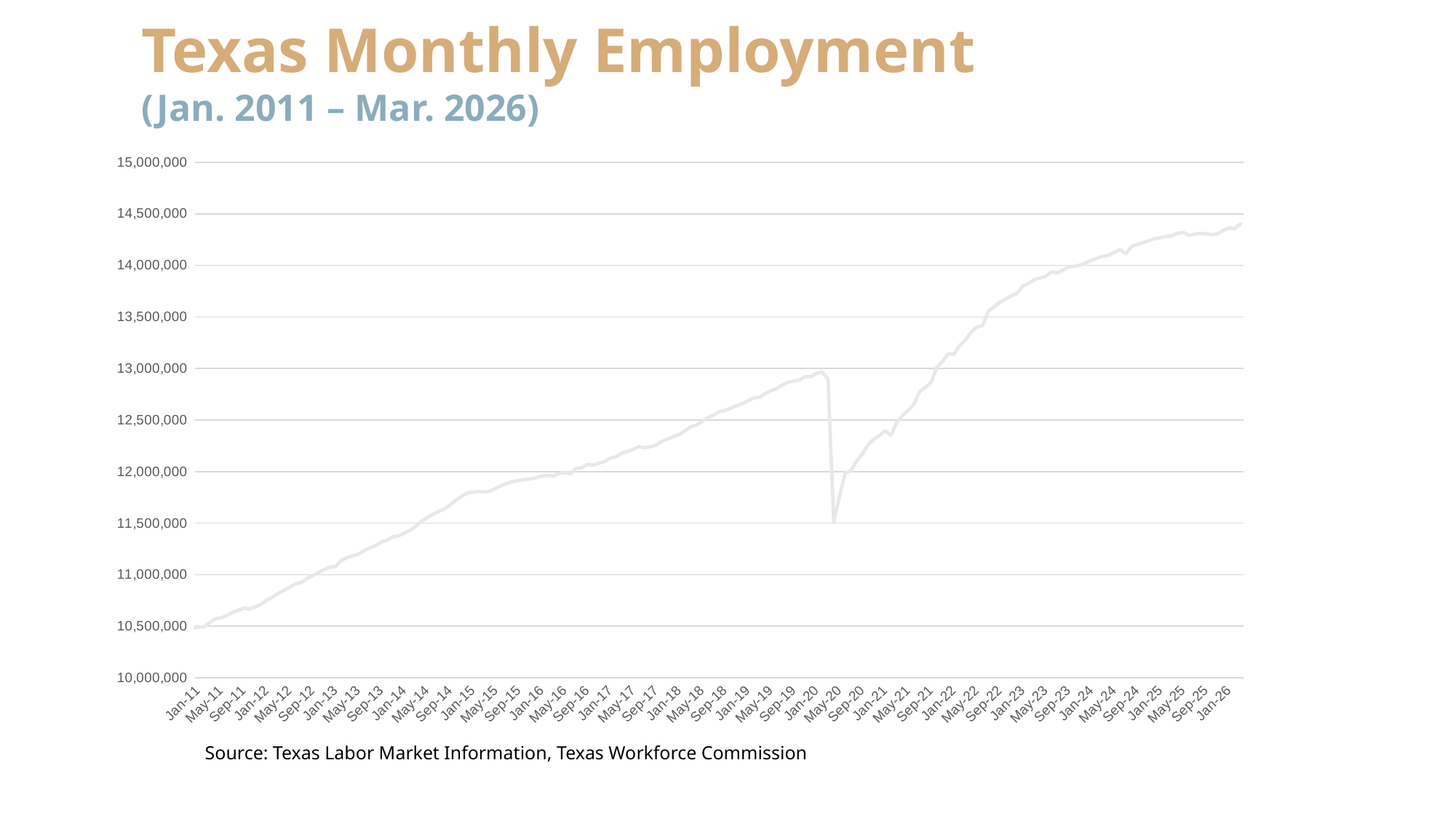
Is the value for Jan-14 greater or less than 11,000,000? greater Is the value for Jan-18 greater or less than 12,000,000? greater Overall, does Texas monthly employment rise or fall from Jan-11 to Jan-26? Rise Is the value for Jan-26 greater or less than 14,500,000? less What kind of chart is shown on the slide? Line chart What is the source cited for the chart data? Texas Labor Market Information, Texas Workforce Commission Which is larger, the value for Jan-19 or the value for Jan-21? Jan-19 What is the title of the chart? Texas Monthly Employment (Jan. 2011 – Mar. 2026) Around which x-axis label does the line show a sharp drop? May-20 Which is larger, the value for Jan-13 or the value for Jan-15? Jan-15